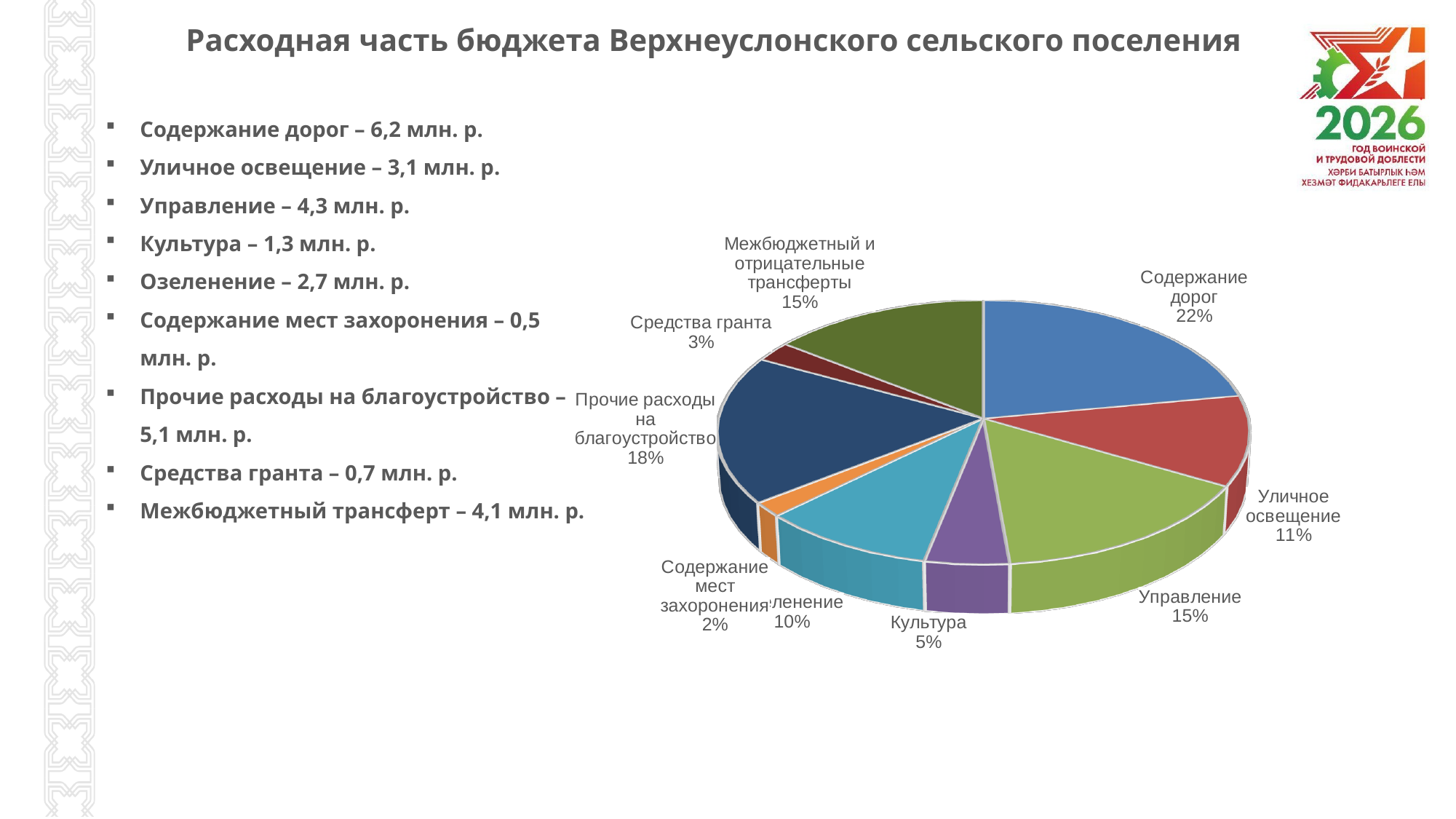
What percentage is shown for Межбюджетный и отрицательные трансферты? 15% Which is larger: Прочие расходы на благоустройство or Управление? Прочие расходы на благоустройство What percentage is shown for Прочие расходы на благоустройство? 18% What percentage is shown for Средства гранта? 3% Which category has the largest slice of the pie? Содержание дорог What percentage is shown for Уличное освещение? 11% What share of the pie does Содержание дорог represent? 22% Which category has the smallest slice of the pie? Содержание мест захоронения What type of chart is shown on the slide? Pie chart What is the title of the slide containing the chart? Расходная часть бюджета Верхнеуслонского сельского поселения How many slices does the pie chart have? 9 What is the difference in percentage points between Содержание дорог and Уличное освещение? 11 percentage points